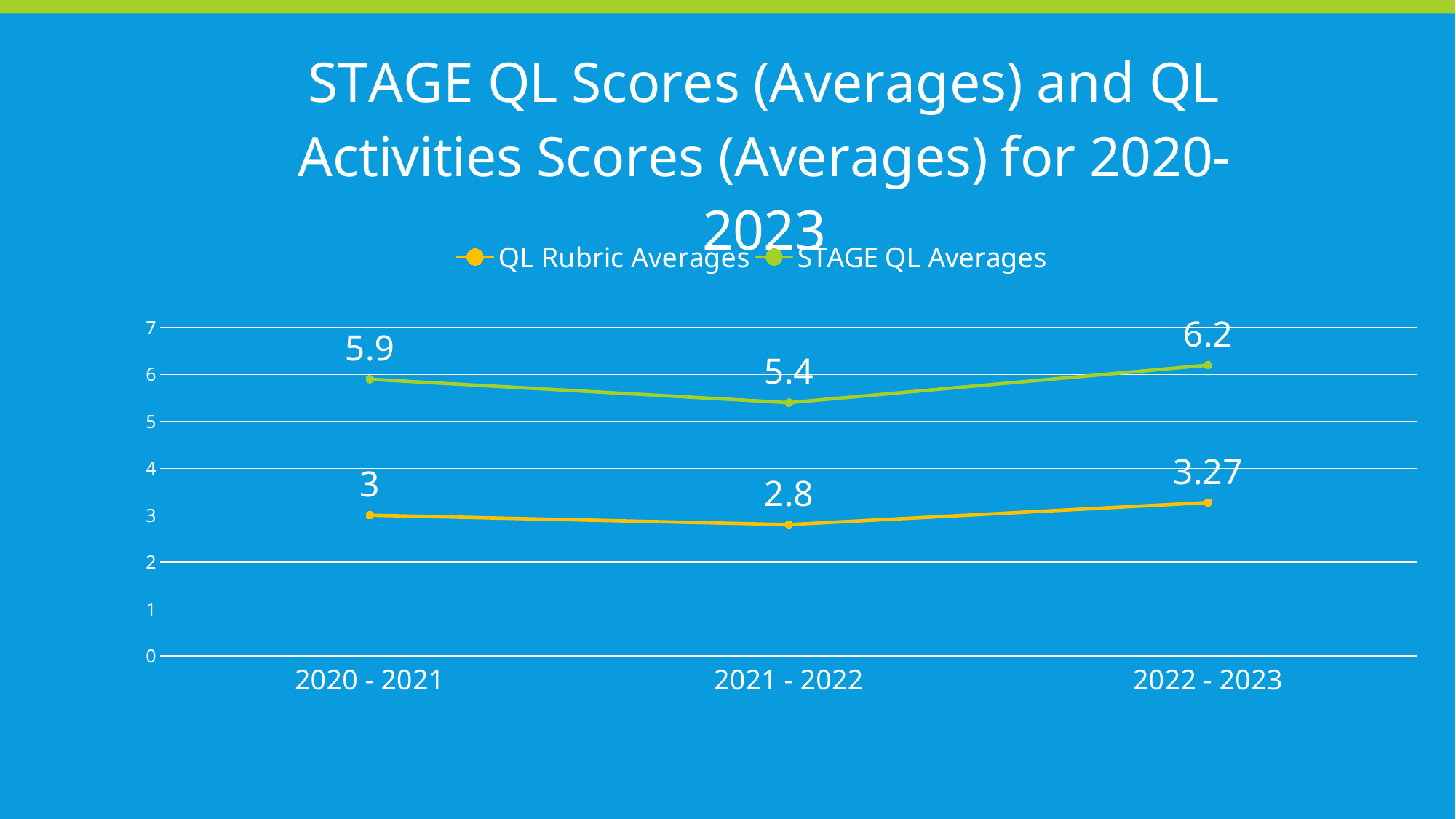
What is the QL Rubric Averages value for 2021 - 2022? 2.8 What is the QL Rubric Averages value for 2022 - 2023? 3.27 What is the STAGE QL Averages value for 2020 - 2021? 5.9 What colour is the line for STAGE QL Averages? green In which period is the STAGE QL Averages value highest? 2022 - 2023 Which series has the larger value in 2021 - 2022, QL Rubric Averages or STAGE QL Averages? STAGE QL Averages What kind of chart is shown on the slide? line chart What is the difference between the STAGE QL Averages and QL Rubric Averages values for 2022 - 2023? 2.93 How many series does the legend list? 2 In which period is the QL Rubric Averages value lowest? 2021 - 2022 Is the STAGE QL Averages value for 2021 - 2022 greater or less than 5? greater How many periods are shown on the x axis? 3